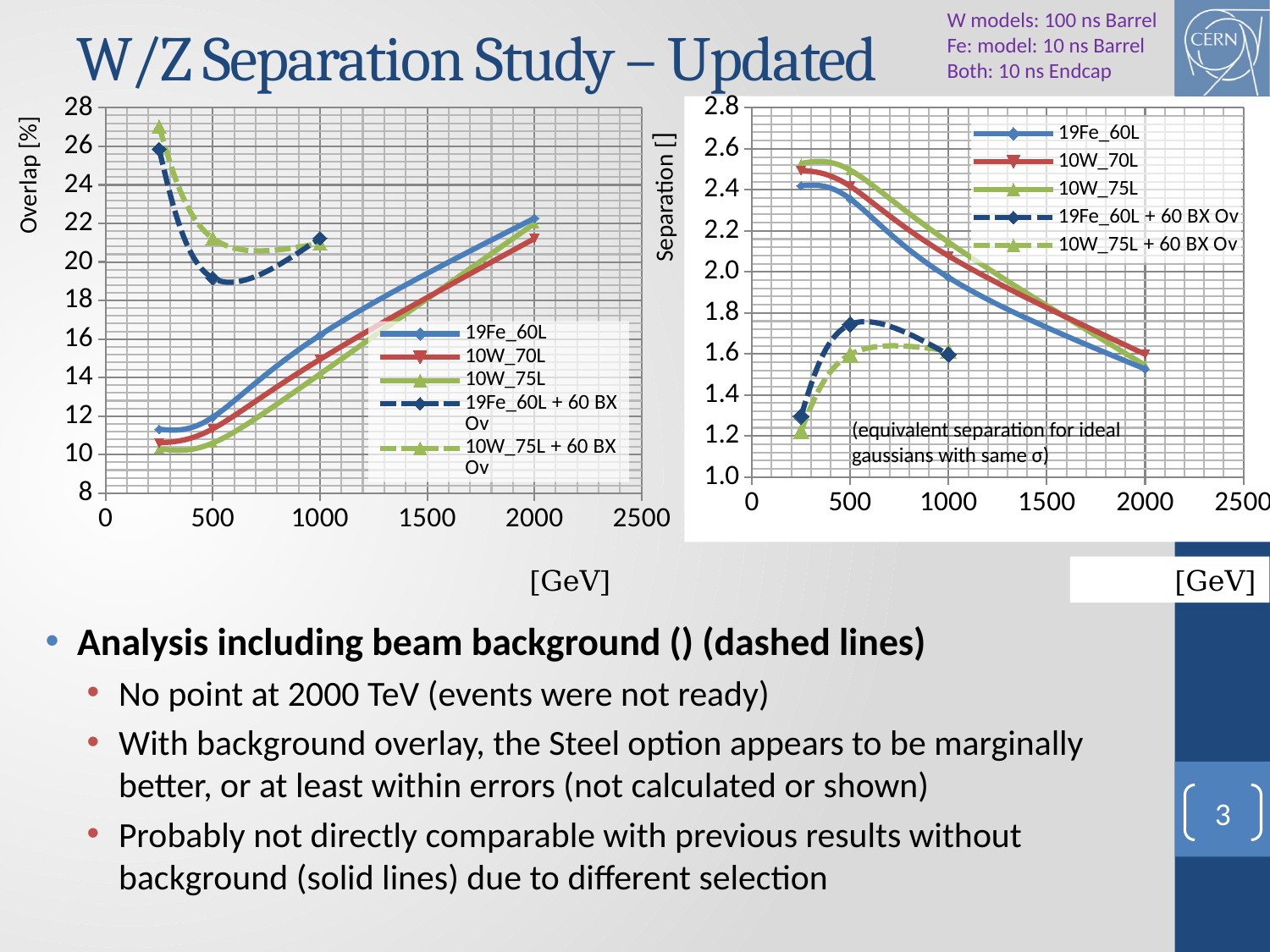
In the left chart (Overlap [%]), is the value for 19Fe_60L at 2000 greater or less than 20? greater In the right chart (Separation), which is larger at 500: 19Fe_60L + 60 BX Ov or 10W_75L + 60 BX Ov? 19Fe_60L + 60 BX Ov In the left chart (Overlap [%]), do the solid-line series rise or fall as the x axis value increases from 250 to 2000? rise In the right chart (Separation), is the value for 10W_70L at 250 greater or less than 2.4? greater What kind of chart is the left chart with the y axis labelled Overlap [%]? line chart In the right chart (Separation), is the value for 19Fe_60L at 2000 greater or less than 1.6? less How many series does the legend of the right chart (Separation) list? 5 What is the y axis label of the right chart? Separation [] How many series does the legend of the left chart (Overlap [%]) list? 5 In the right chart (Separation), do the solid-line series rise or fall as the x axis value increases from 250 to 2000? fall In the left chart (Overlap [%]), which is larger at 500: 10W_75L + 60 BX Ov or 19Fe_60L + 60 BX Ov? 10W_75L + 60 BX Ov